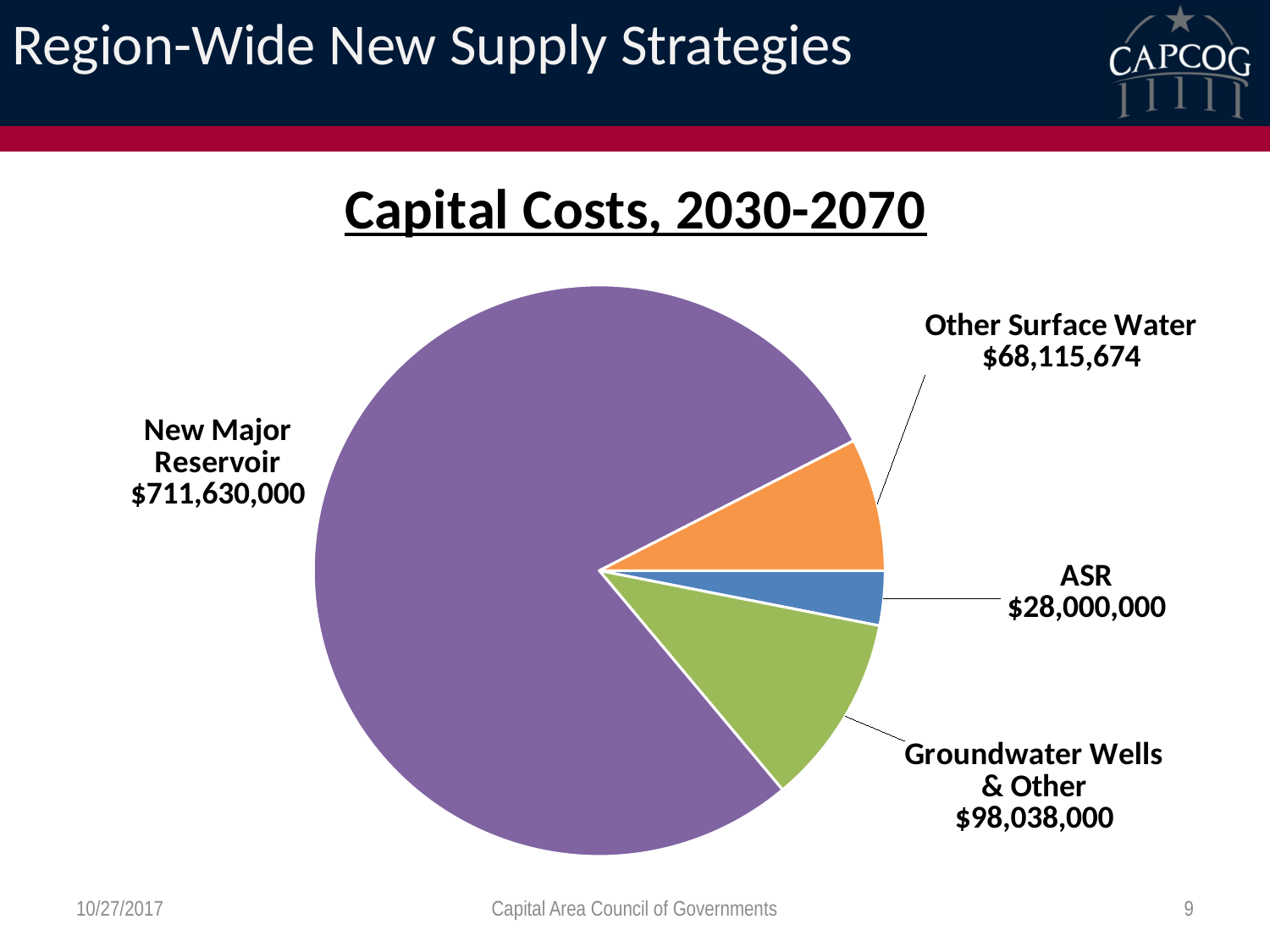
What is the difference between the capital cost for Groundwater Wells & Other and the capital cost for ASR? $70,038,000 What is the capital cost for Groundwater Wells & Other? $98,038,000 How many slices does the pie chart have? 4 What is the title of the chart? Capital Costs, 2030-2070 What colour is the New Major Reservoir slice? Purple What is the capital cost for New Major Reservoir? $711,630,000 Which category has the largest capital cost? New Major Reservoir What is the capital cost for Other Surface Water? $68,115,674 What is the capital cost for ASR? $28,000,000 What kind of chart is shown on the slide? Pie chart Which has a larger capital cost, Groundwater Wells & Other or Other Surface Water? Groundwater Wells & Other Which category has the smallest capital cost? ASR